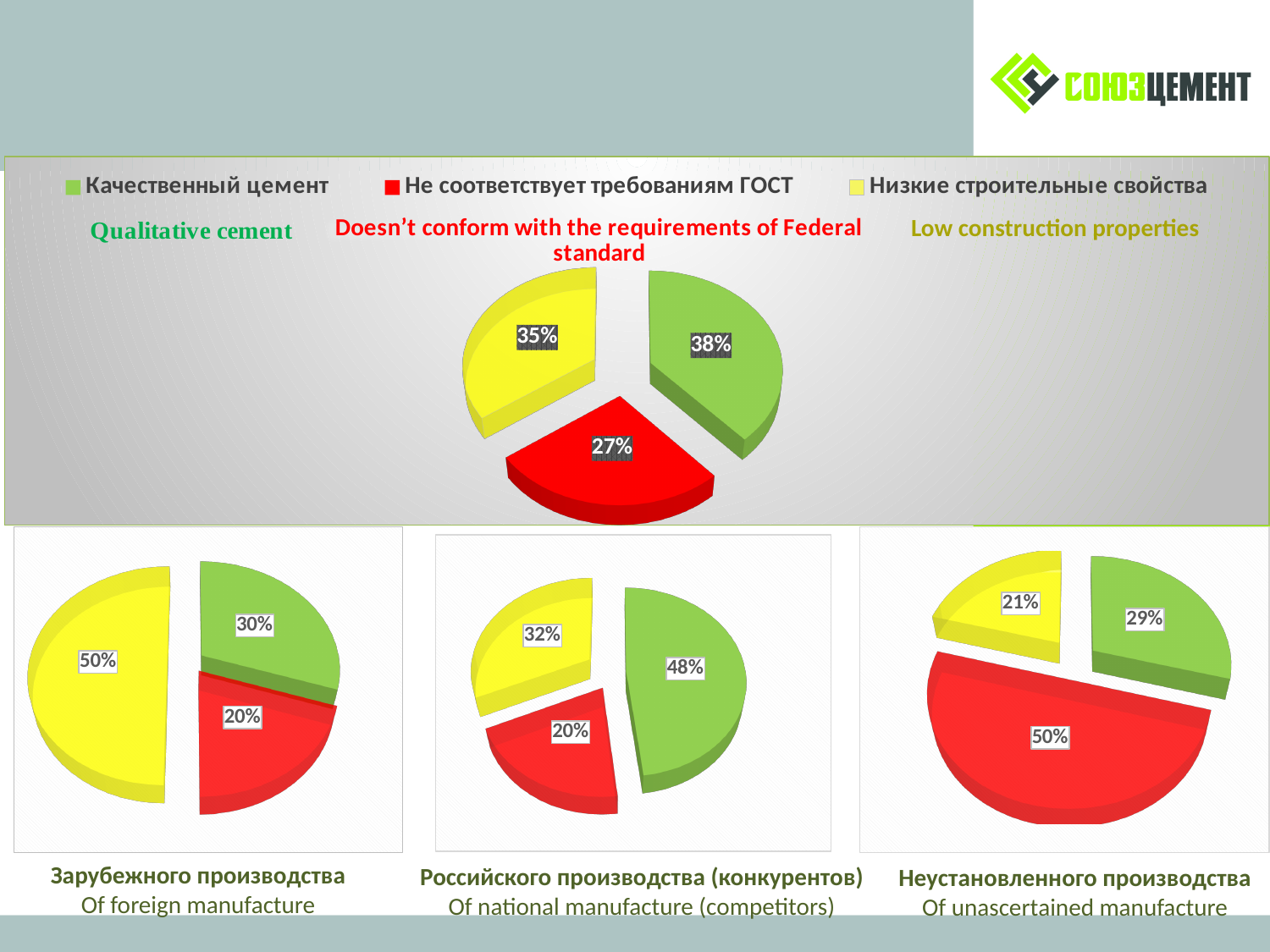
In the 'Of foreign manufacture' pie chart, which category has the largest share? Low construction properties What type of chart is used on this slide? Pie chart In the top pie chart, what share is labelled for Qualitative cement (green slice)? 38% In the 'Of unascertained manufacture' pie chart, what share is labelled for the red slice (doesn't conform with Federal standard)? 50% In the 'Of national manufacture (competitors)' pie chart, what share is labelled for Qualitative cement? 48% How many slices does each pie chart on the slide have? 3 In the top pie chart, what share is labelled for the slice that doesn't conform with the requirements of Federal standard (red)? 27% In the 'Of unascertained manufacture' pie chart, which is larger: the Qualitative cement share or the Low construction properties share? Qualitative cement In the 'Of national manufacture (competitors)' pie chart, what is the difference between the Qualitative cement share and the Low construction properties share? 16% In the 'Of foreign manufacture' pie chart, what share is labelled for Low construction properties (yellow slice)? 50% In the top pie chart, which category has the smallest share? Doesn't conform with the requirements of Federal standard Which colour represents Qualitative cement in the legend? Green